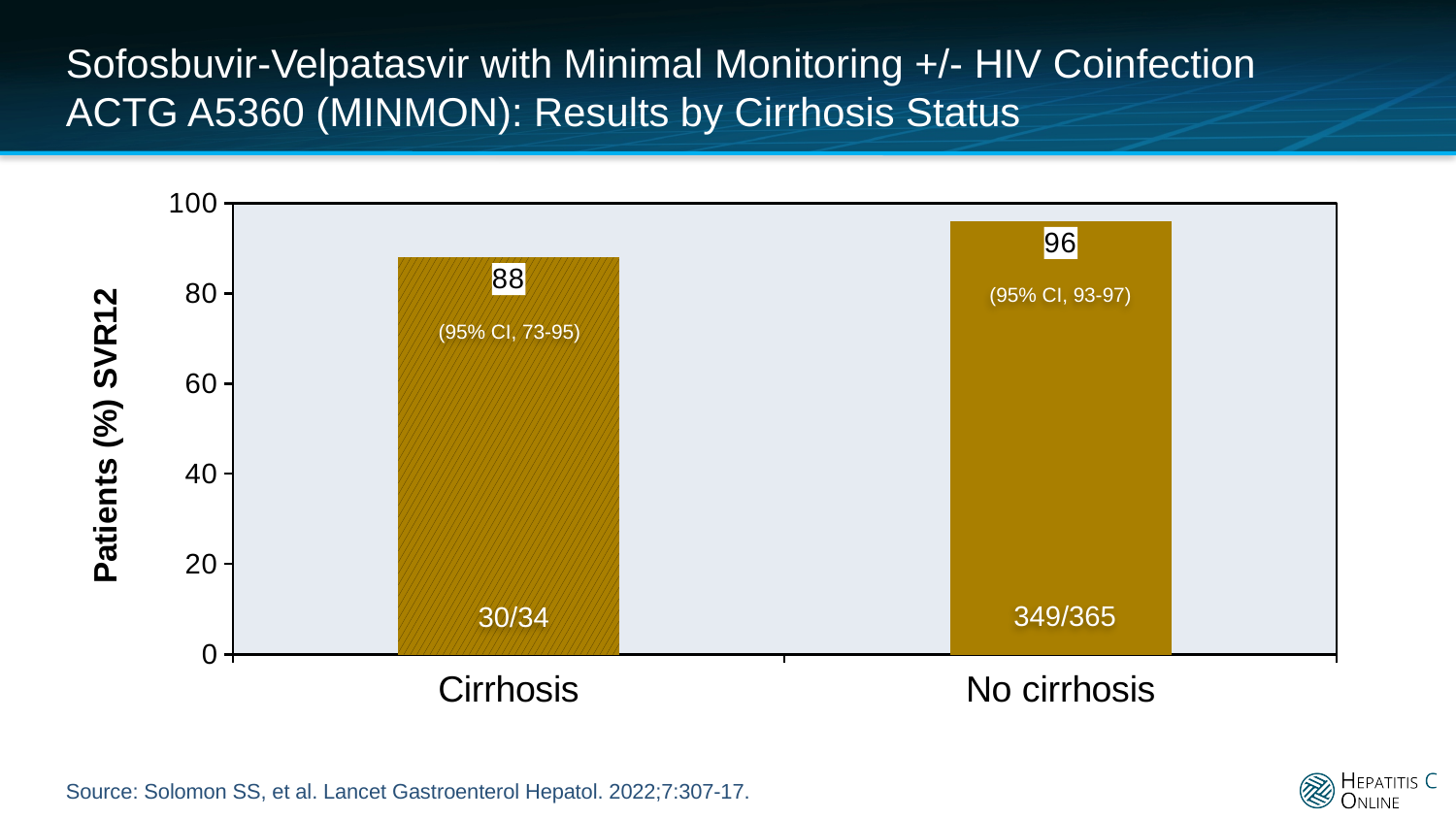
What is the 95% confidence interval shown for the Cirrhosis group? 73-95 What kind of chart is shown on the slide? Bar chart How many categories are shown on the x axis? 2 What fraction of patients achieved SVR12 in the Cirrhosis group? 30/34 Is the value for Cirrhosis greater or less than 80? greater What is the difference in SVR12 rate between the No cirrhosis and Cirrhosis groups? 8 Which category has the higher SVR12 rate? No cirrhosis What fraction of patients achieved SVR12 in the No cirrhosis group? 349/365 What is the SVR12 rate (%) for patients with no cirrhosis? 96 What is the SVR12 rate (%) for patients with cirrhosis? 88 Which category has the lower SVR12 rate? Cirrhosis Is the SVR12 rate higher for patients with cirrhosis or without cirrhosis? No cirrhosis